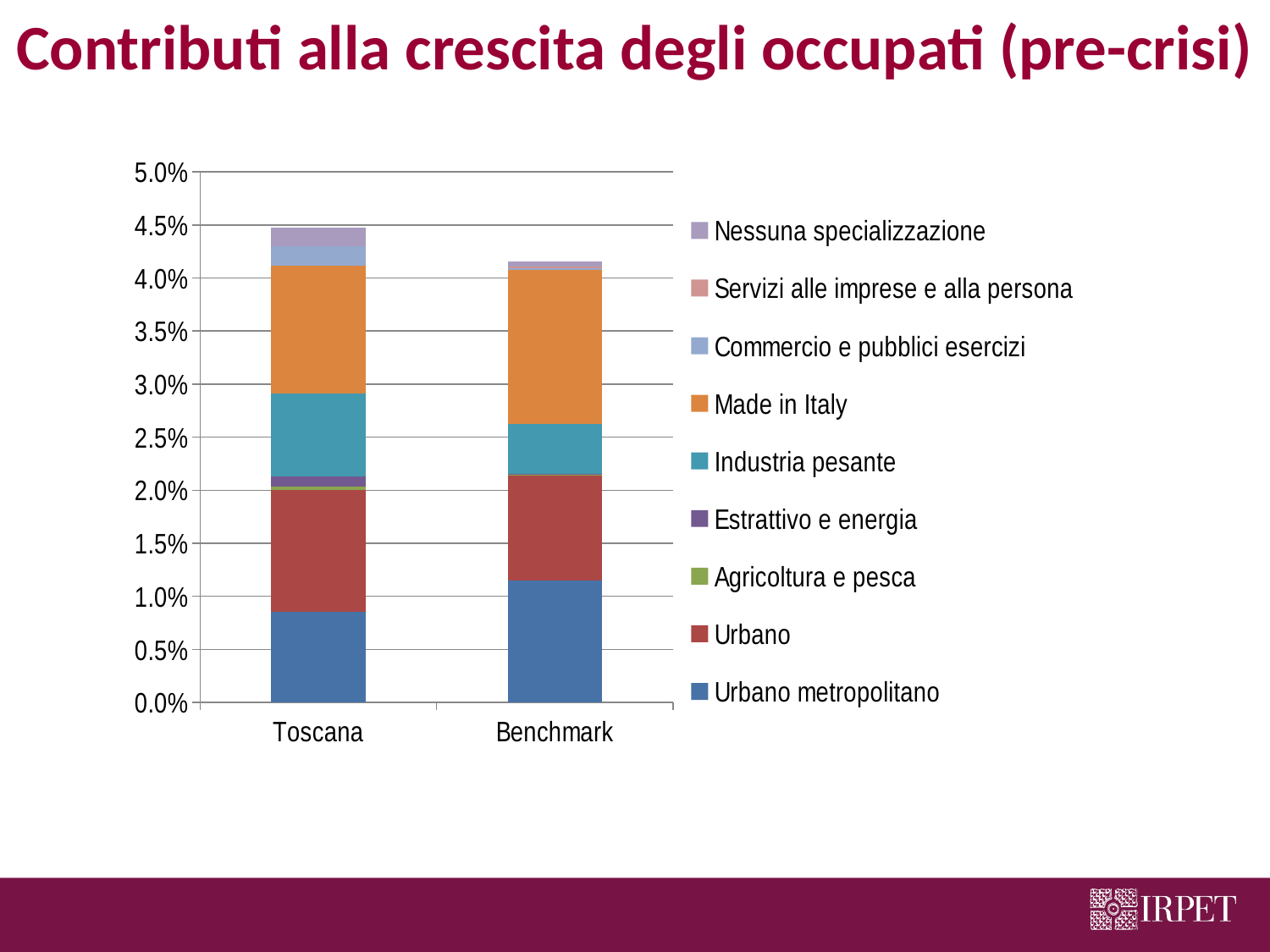
Is the Urbano metropolitano segment for Benchmark greater or less than 1.5%? less Which series is listed at the top of the chart's legend? Nessuna specializzazione How many series does the chart's legend list? 9 What is the title of the slide containing the chart? Contributi alla crescita degli occupati (pre-crisi) Which category has the larger Urbano metropolitano segment, Toscana or Benchmark? Benchmark Is the total height of the Toscana bar greater or less than 4.0%? greater How many categories are shown on the x axis of the chart? 2 Is the total height of the Benchmark bar greater or less than 4.5%? less What kind of chart is shown on the slide? Stacked bar chart Which category has the taller stacked bar, Toscana or Benchmark? Toscana Which category has the larger Industria pesante segment, Toscana or Benchmark? Toscana